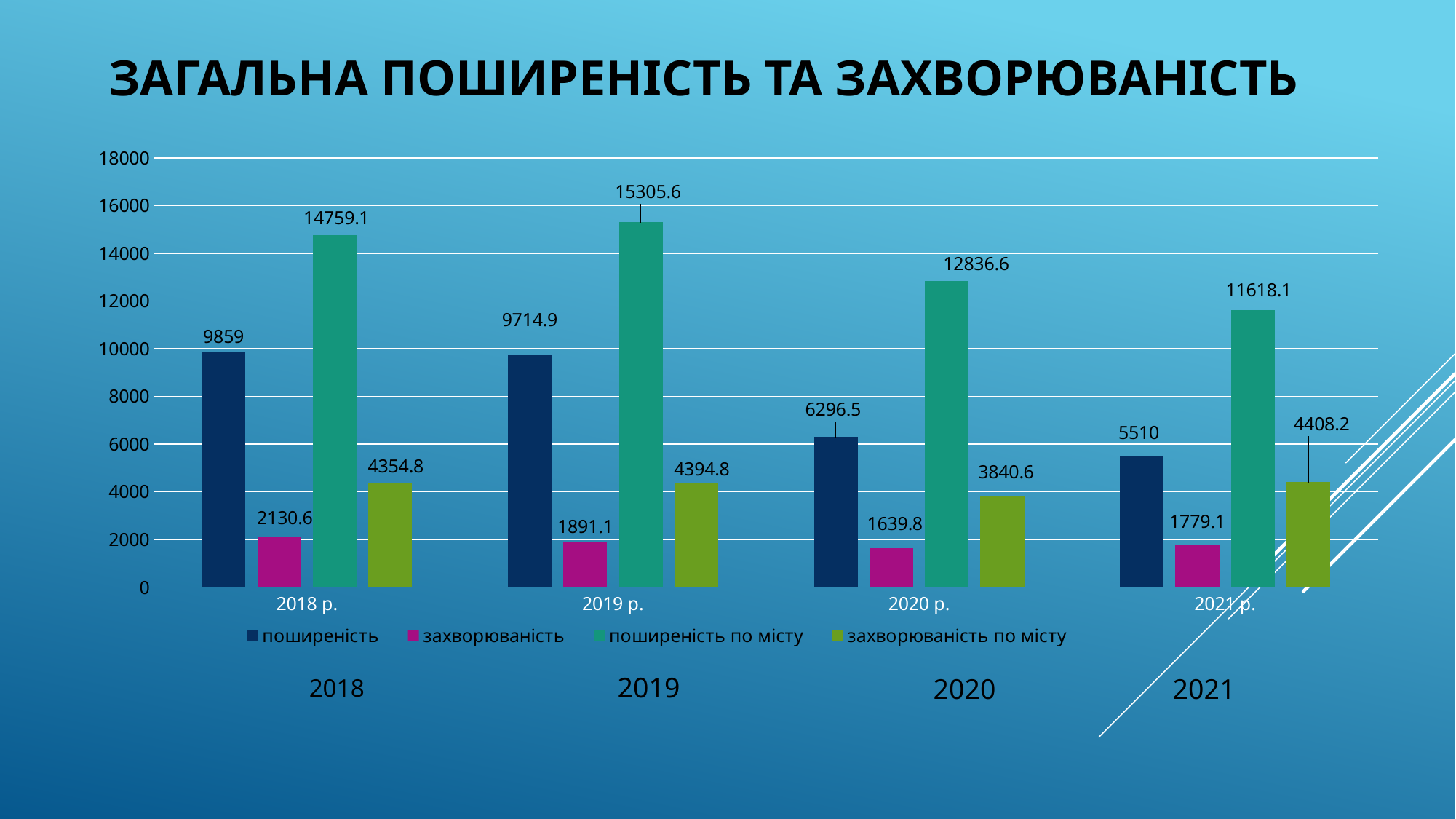
What is the difference between поширеність in 2018 р. and in 2021 р.? 4349 What is the value of захворюваність по місту for 2021 р.? 4408.2 What is the value of поширеність for 2018 р.? 9859 What is the value of поширеність по місту for 2019 р.? 15305.6 Which is larger: захворюваність по місту in 2019 р. or in 2020 р.? 2019 р. In which year is поширеність по місту the highest? 2019 р. What is the value of захворюваність for 2020 р.? 1639.8 Is the value of поширеність for 2020 р. greater or less than 8000? less In which year is захворюваність the lowest? 2020 р. Does поширеність rise or fall from 2018 р. to 2021 р.? fall How many years are shown on the x axis? 4 How many series does the legend list? 4